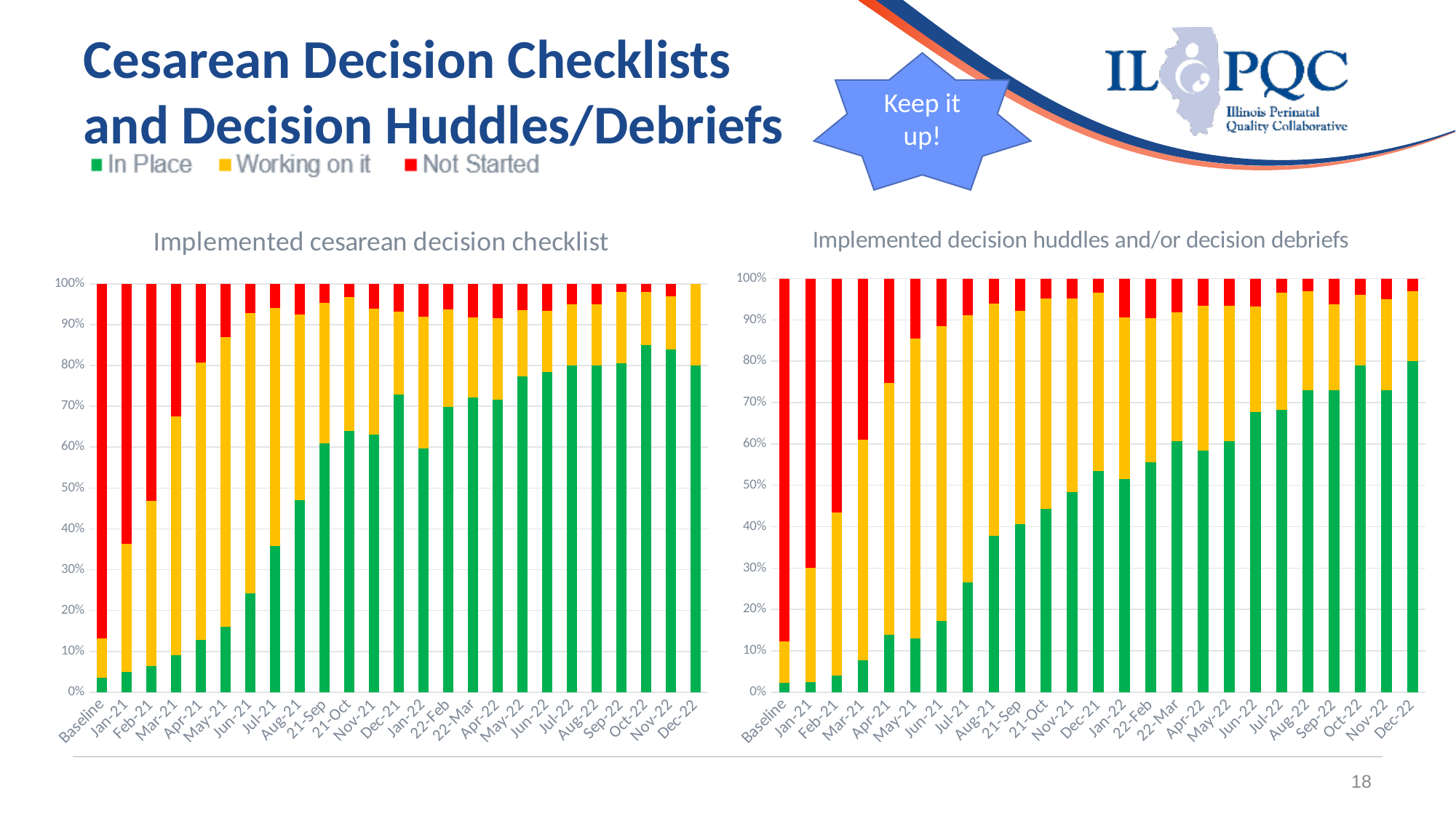
How many series does the legend list for the charts on this slide? 3 What kind of chart is the 'Implemented cesarean decision checklist' chart? Stacked bar chart In the 'Implemented decision huddles and/or decision debriefs' chart, does the 'In Place' share generally rise or fall from Baseline to Dec-22? Rise In the 'Implemented decision huddles and/or decision debriefs' chart, is the 'Not Started' share for Baseline greater or less than 80%? greater How many categories are shown on the x axis of the 'Implemented decision huddles and/or decision debriefs' chart? 25 In the 'Implemented decision huddles and/or decision debriefs' chart, is the 'In Place' value for Jul-21 greater or less than 30%? less In the 'Implemented cesarean decision checklist' chart, which category has the largest 'Not Started' share? Baseline In the 'Implemented cesarean decision checklist' chart, which is larger, the 'In Place' value for Jun-21 or for Jul-21? Jul-21 Which colour represents 'Working on it' in the legend? Yellow In the 'Implemented decision huddles and/or decision debriefs' chart, which is larger, the 'In Place' value for Apr-21 or for Jul-21? Jul-21 In the 'Implemented cesarean decision checklist' chart, is the 'In Place' value for Dec-22 greater or less than 70%? greater